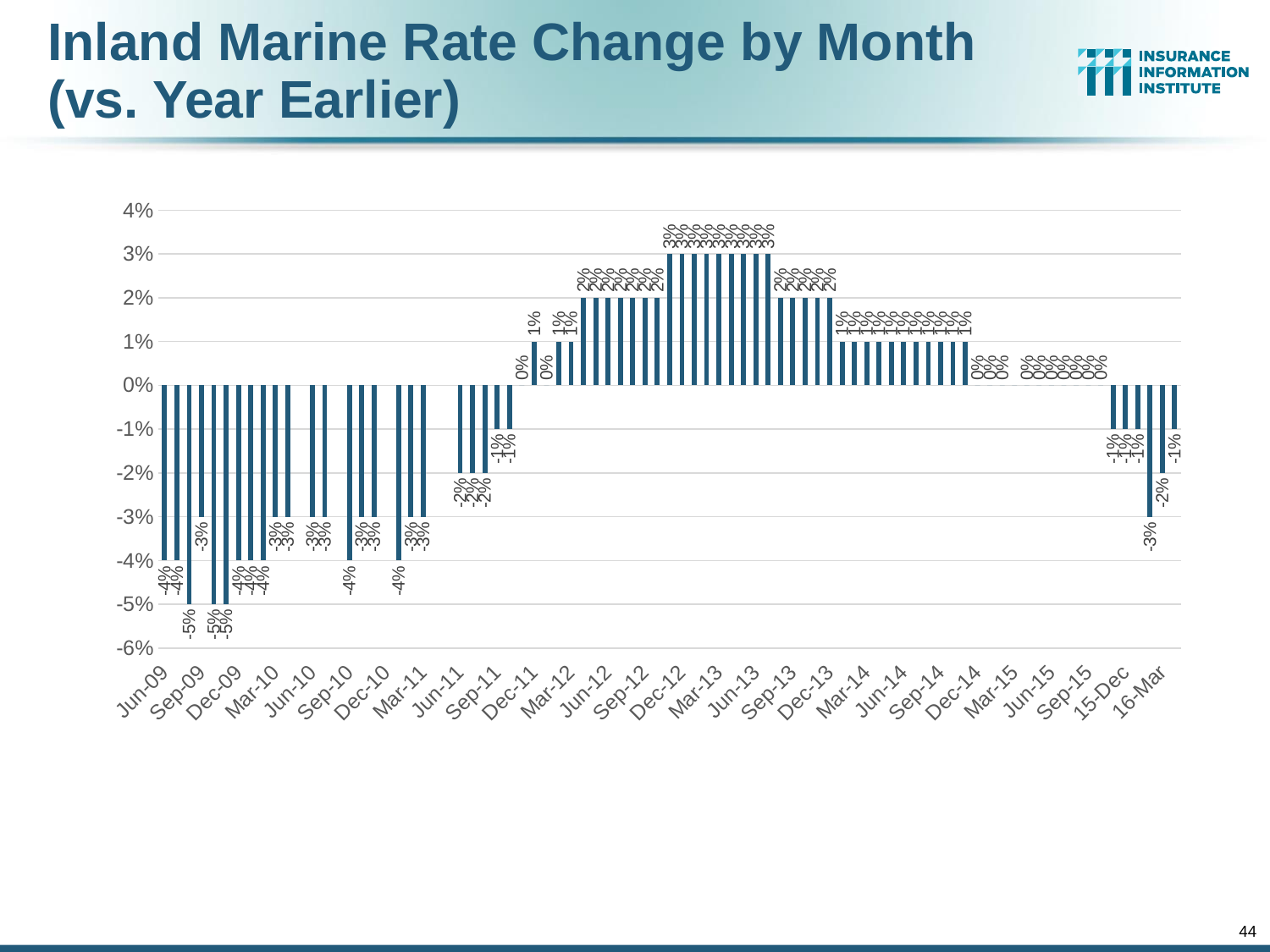
What is the rate change shown for Jun-15? 0% Is the value for Dec-09 greater or less than -3%? less What is the lowest rate change value labeled on the chart? -5% What kind of chart is shown on the slide? Bar chart Which is larger, the rate change for Mar-13 or for Mar-15? Mar-13 What is the title of the chart on the slide? Inland Marine Rate Change by Month (vs. Year Earlier) Is the value for Sep-12 greater or less than 1%? greater What is the rate change shown for Mar-13? 3% Do the rate changes generally rise or fall from Jun-09 to Mar-13? Rise What is the difference between the highest labeled value (3%) and the lowest labeled value (-5%)? 8 percentage points What is the highest rate change value labeled on the chart? 3%